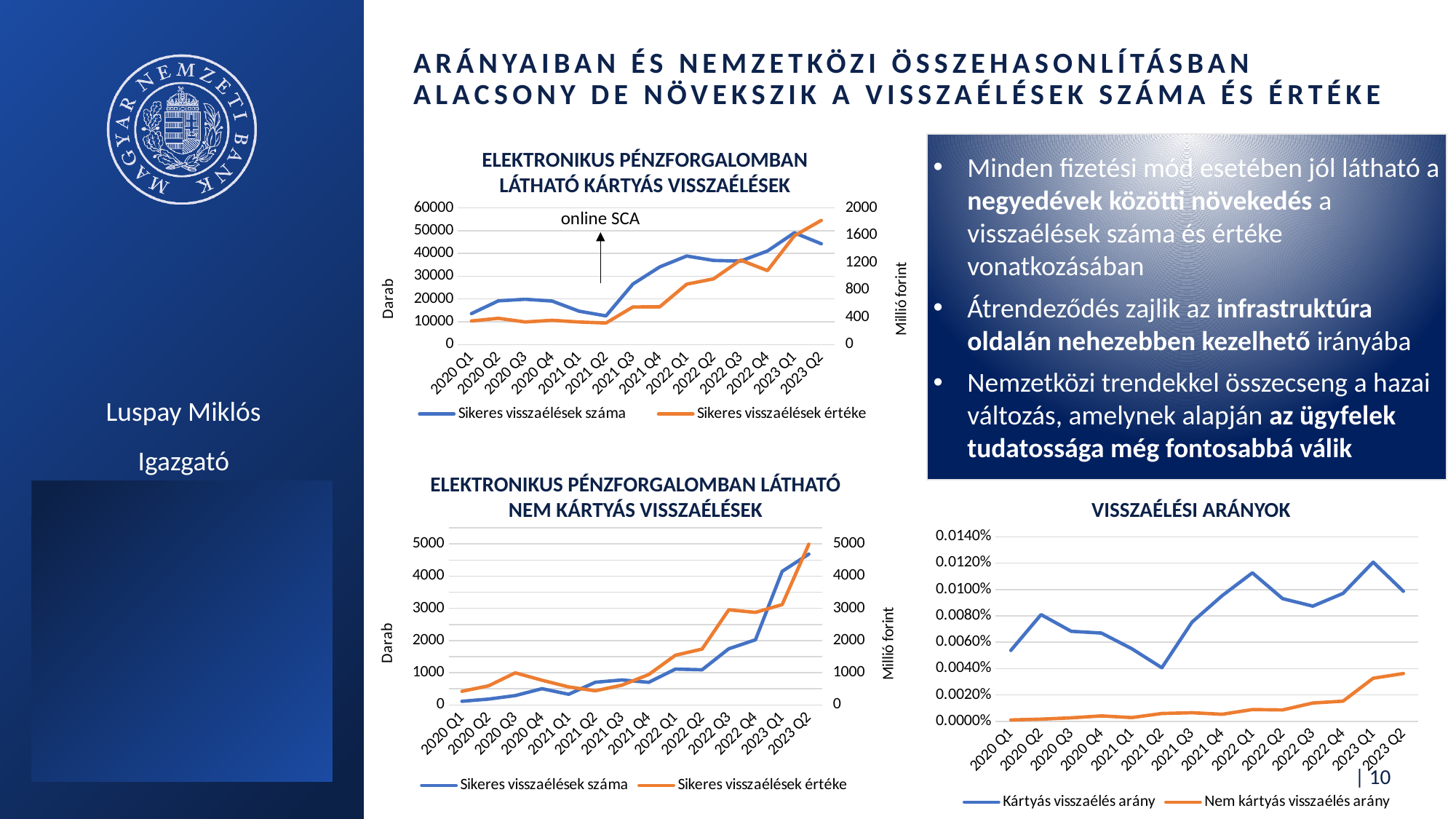
What kind of chart is "ELEKTRONIKUS PÉNZFORGALOMBAN LÁTHATÓ KÁRTYÁS VISSZAÉLÉSEK"? Line chart In the chart "ELEKTRONIKUS PÉNZFORGALOMBAN LÁTHATÓ KÁRTYÁS VISSZAÉLÉSEK", how many quarters are shown on the x axis? 14 In the chart "ELEKTRONIKUS PÉNZFORGALOMBAN LÁTHATÓ NEM KÁRTYÁS VISSZAÉLÉSEK", is the value of "Sikeres visszaélések száma" for 2020 Q1 greater or less than 1000? less In the chart "VISSZAÉLÉSI ARÁNYOK", which series is higher in 2023 Q2, "Kártyás visszaélés arány" or "Nem kártyás visszaélés arány"? Kártyás visszaélés arány In the chart "ELEKTRONIKUS PÉNZFORGALOMBAN LÁTHATÓ NEM KÁRTYÁS VISSZAÉLÉSEK", in which quarter does "Sikeres visszaélések száma" reach its highest value? 2023 Q2 In the chart "ELEKTRONIKUS PÉNZFORGALOMBAN LÁTHATÓ KÁRTYÁS VISSZAÉLÉSEK", is the value of "Sikeres visszaélések értéke" for 2023 Q2 greater or less than 1600? greater In the chart "VISSZAÉLÉSI ARÁNYOK", does "Nem kártyás visszaélés arány" generally rise or fall from 2020 Q1 to 2023 Q2? Rise In the chart "ELEKTRONIKUS PÉNZFORGALOMBAN LÁTHATÓ KÁRTYÁS VISSZAÉLÉSEK", in which quarter does "Sikeres visszaélések száma" reach its highest value? 2023 Q1 In the chart "VISSZAÉLÉSI ARÁNYOK", in which quarter is "Kártyás visszaélés arány" at its lowest? 2021 Q2 In the chart "VISSZAÉLÉSI ARÁNYOK", in which quarter is "Kártyás visszaélés arány" at its highest? 2023 Q1 How many series does the legend of the chart "ELEKTRONIKUS PÉNZFORGALOMBAN LÁTHATÓ NEM KÁRTYÁS VISSZAÉLÉSEK" list? 2 In the chart "ELEKTRONIKUS PÉNZFORGALOMBAN LÁTHATÓ KÁRTYÁS VISSZAÉLÉSEK", is the value of "Sikeres visszaélések száma" for 2021 Q2 greater or less than 10000? greater